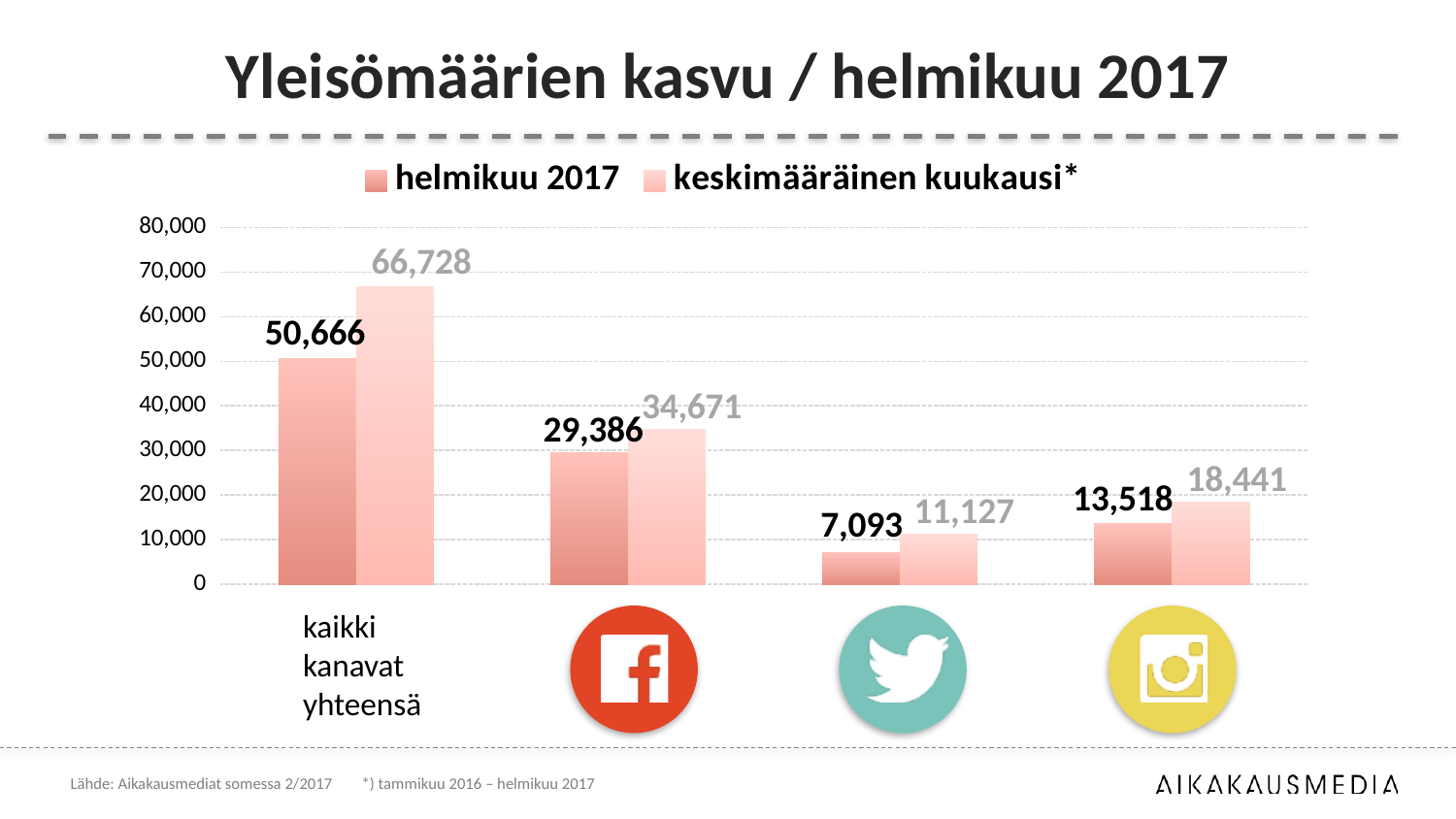
Which is larger for the Facebook category: the helmikuu 2017 value or the keskimääräinen kuukausi* value? keskimääräinen kuukausi* What is the difference between the helmikuu 2017 values for Instagram and Twitter? 6,425 What is the keskimääräinen kuukausi* value for the Facebook category? 34,671 What is the value for helmikuu 2017 for kaikki kanavat yhteensä? 50,666 Which category has the highest keskimääräinen kuukausi* value? kaikki kanavat yhteensä What is the helmikuu 2017 value for the Twitter category? 7,093 What is the difference between the keskimääräinen kuukausi* and helmikuu 2017 values for kaikki kanavat yhteensä? 16,062 What is the keskimääräinen kuukausi* value for the Instagram category? 18,441 What kind of chart is shown on the slide? bar chart How many categories are shown on the x axis? 4 Which category has the lowest helmikuu 2017 value? Twitter How many series does the legend list? 2